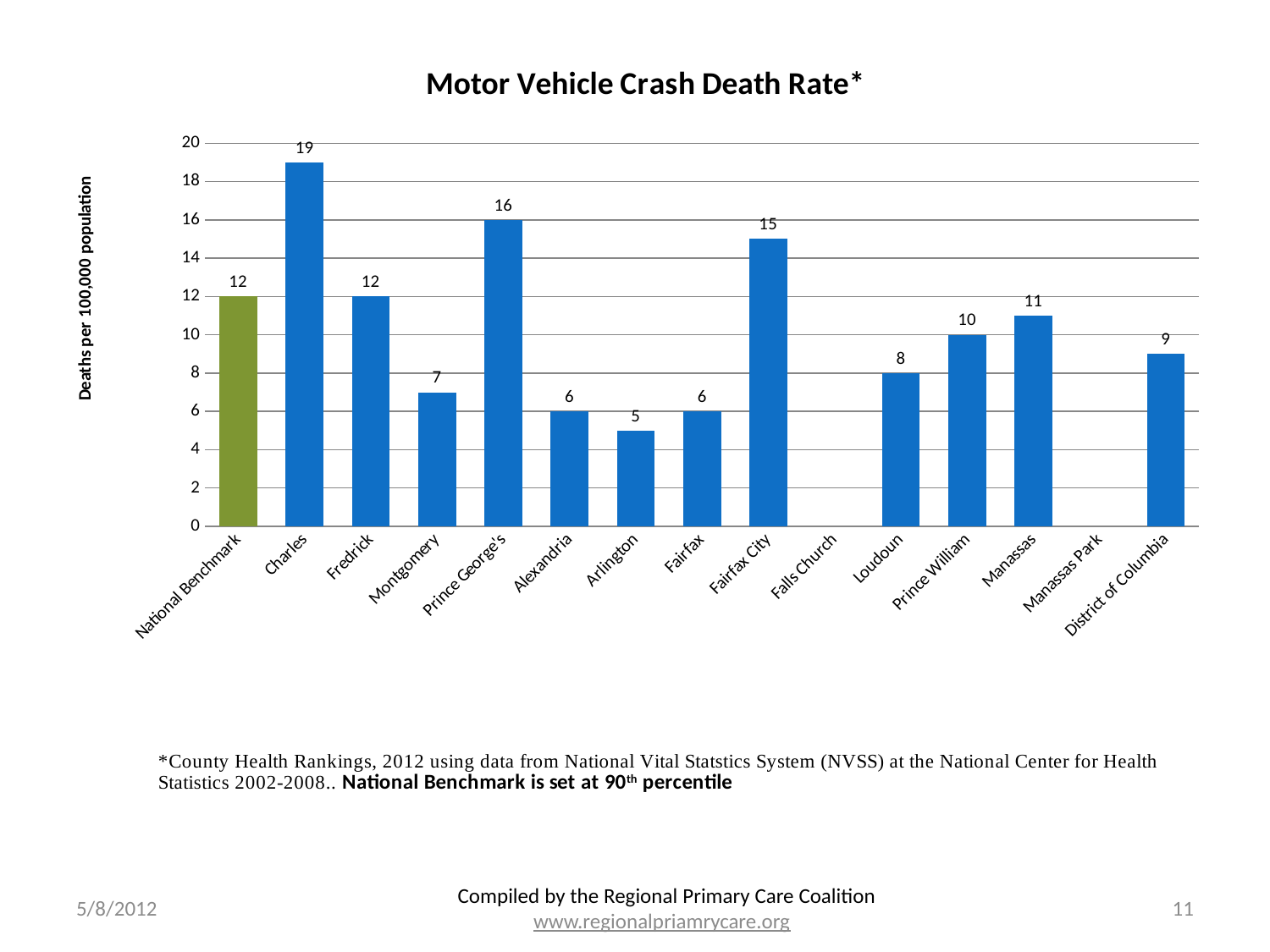
What is the motor vehicle crash death rate for Charles? 19 What is the value shown for Arlington? 5 Which category has the highest motor vehicle crash death rate? Charles What is the value shown for Prince George's? 16 What is the title of the chart? Motor Vehicle Crash Death Rate* What is the value shown for the National Benchmark? 12 What is the difference between the values for Charles and Fairfax City? 4 What is the difference between the values for Manassas and Loudoun? 3 What kind of chart is shown on the slide? Bar chart Among the categories with a plotted bar, which has the lowest value? Arlington Which is larger, the value for Montgomery or the value for District of Columbia? District of Columbia How many categories are listed on the x axis? 15